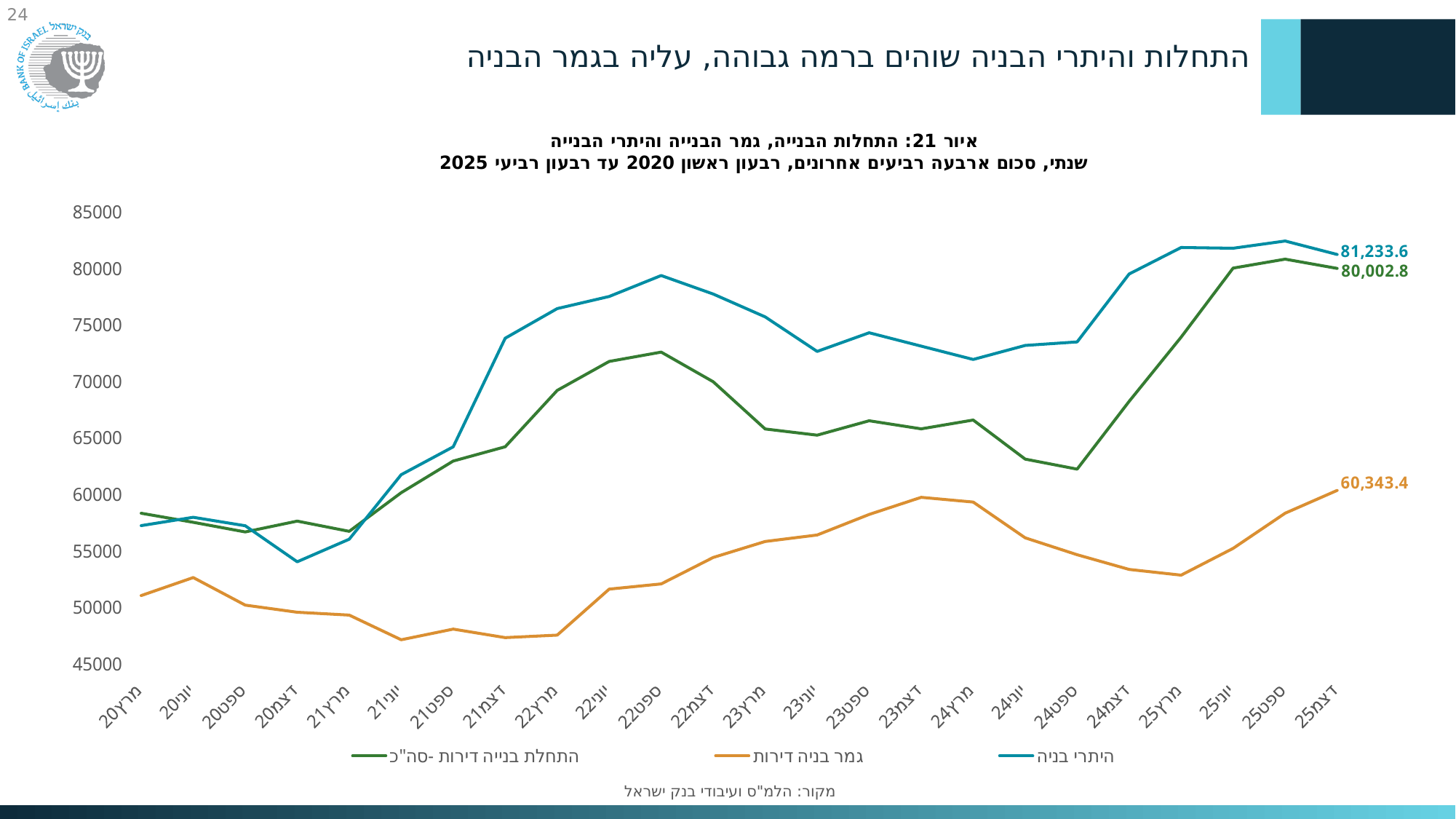
Does the גמר בניה דירות line rise or fall from ספט24 to דצמ25? rise How many series does the legend list? 3 What type of chart is shown on the slide? Line chart What is the value of היתרי בניה at דצמ25? 81,233.6 What is the value of גמר בניה דירות at דצמ25? 60,343.4 Is the value of היתרי בניה at ספט22 greater or less than 75000? greater What is the value of התחלת בנייה דירות -סה"כ at דצמ25? 80,002.8 Which series has the highest value at דצמ25? היתרי בניה Which series has the lowest value at דצמ25? גמר בניה דירות How many points are on the x axis (from מרץ20 to דצמ25)? 24 Is the value of גמר בניה דירות at דצמ21 greater or less than 50000? less What is the difference between היתרי בניה and התחלת בנייה דירות -סה"כ at דצמ25? 1,230.8